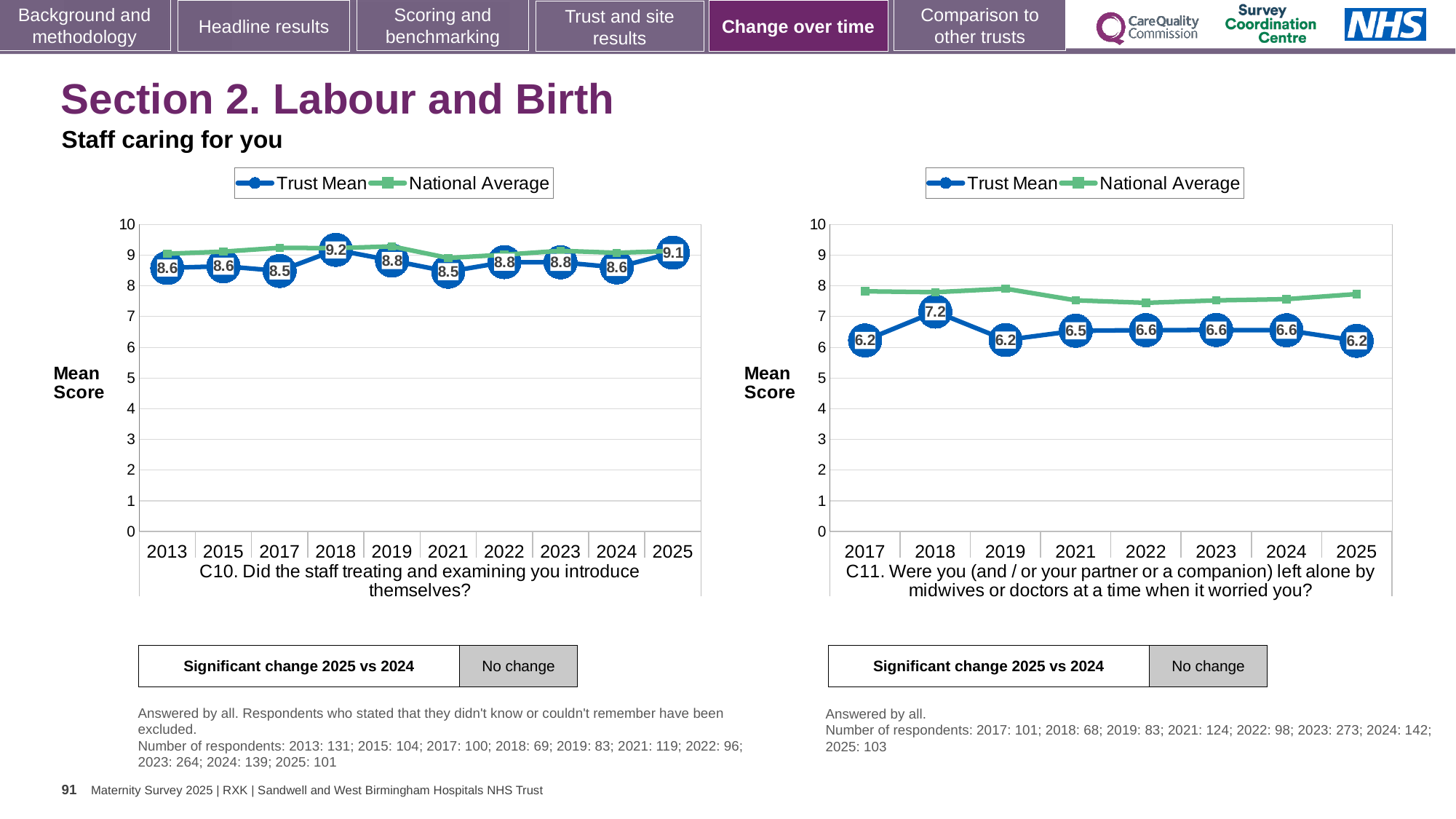
In the C11 chart on the right, is the National Average value for 2017 greater or less than 7? greater In the C10 chart on the left, what is the Trust Mean score for 2018? 9.2 In the C11 chart on the right, what is the Trust Mean score for 2018? 7.2 In the C11 chart on the right, what is the difference between the Trust Mean scores for 2018 and 2025? 1.0 In the C11 chart on the right, is the Trust Mean score for 2022 larger or smaller than the score for 2025? larger How many years are shown on the x axis of the C10 chart on the left? 10 In the C11 chart on the right, which year has the highest Trust Mean score? 2018 In the C10 chart on the left, what is the difference between the Trust Mean scores for 2018 and 2017? 0.7 What kind of chart is the C11 chart on the right? line chart In the C10 chart on the left, what is the Trust Mean score for 2025? 9.1 In the C10 chart on the left, which year has the highest Trust Mean score? 2018 In the C11 chart on the right, what is the Trust Mean score for 2021? 6.5